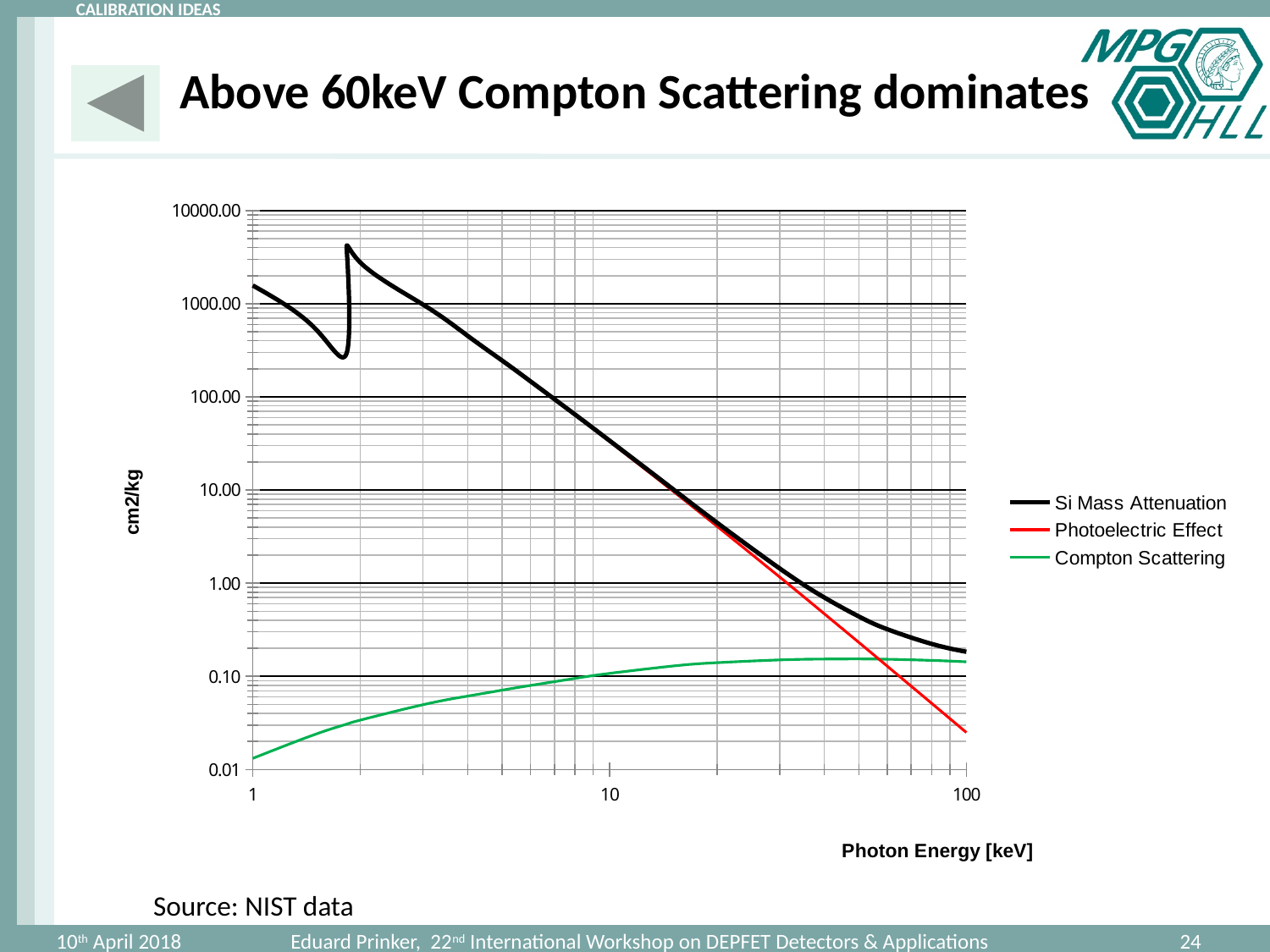
What is the title of the x axis? Photon Energy [keV] At 100 keV, which is larger: Compton Scattering or the Photoelectric Effect? Compton Scattering At 10 keV, which is larger: the Photoelectric Effect or Compton Scattering? Photoelectric Effect Is the value of Si Mass Attenuation at 1 keV greater or less than 1000.00? greater How many series does the legend list? 3 Is the value of Si Mass Attenuation at 10 keV greater or less than 10.00? greater What is the title of the y axis? cm2/kg Is the value of the Photoelectric Effect at 100 keV greater or less than 0.10? less What kind of chart is shown on the slide? line chart Does the Photoelectric Effect line rise or fall as photon energy increases from 1 to 100 keV? falls